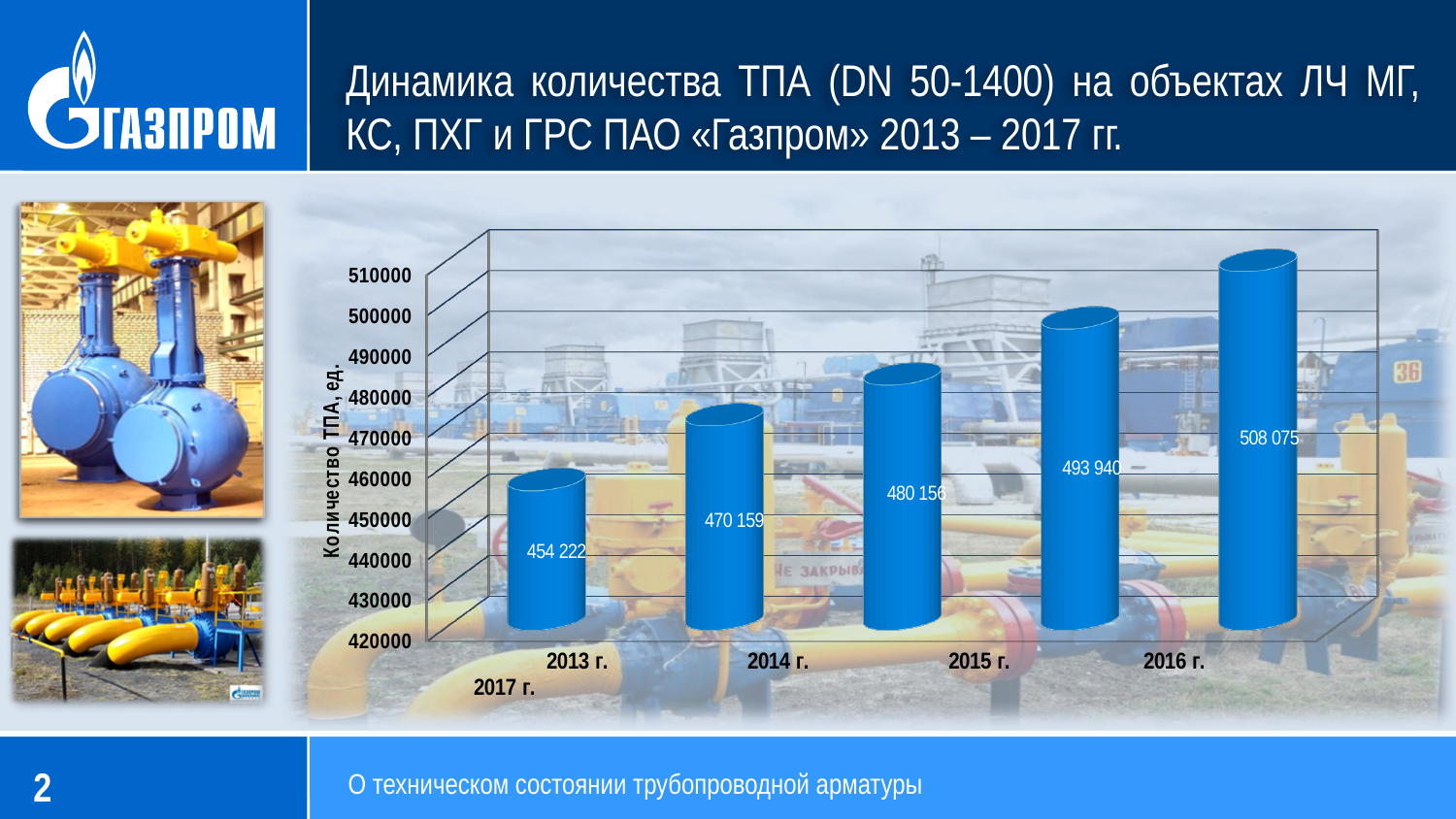
What is the value for 2013 г.? 454 222 Which year has the lowest value? 2013 г. Which is larger, the value for 2015 г. or the value for 2016 г.? 2016 г. What is the highest value shown in the chart? 508 075 What is the value for 2014 г.? 470 159 What is the value shown on the rightmost (tallest) bar? 508 075 How many bars are shown in the chart? 5 Do the values rise or fall from left to right along the x axis? rise What is the value for 2015 г.? 480 156 What is the value for 2016 г.? 493 940 What is the difference between the values for 2014 г. and 2013 г.? 15 937 Is the value for 2013 г. greater or less than 460000? less